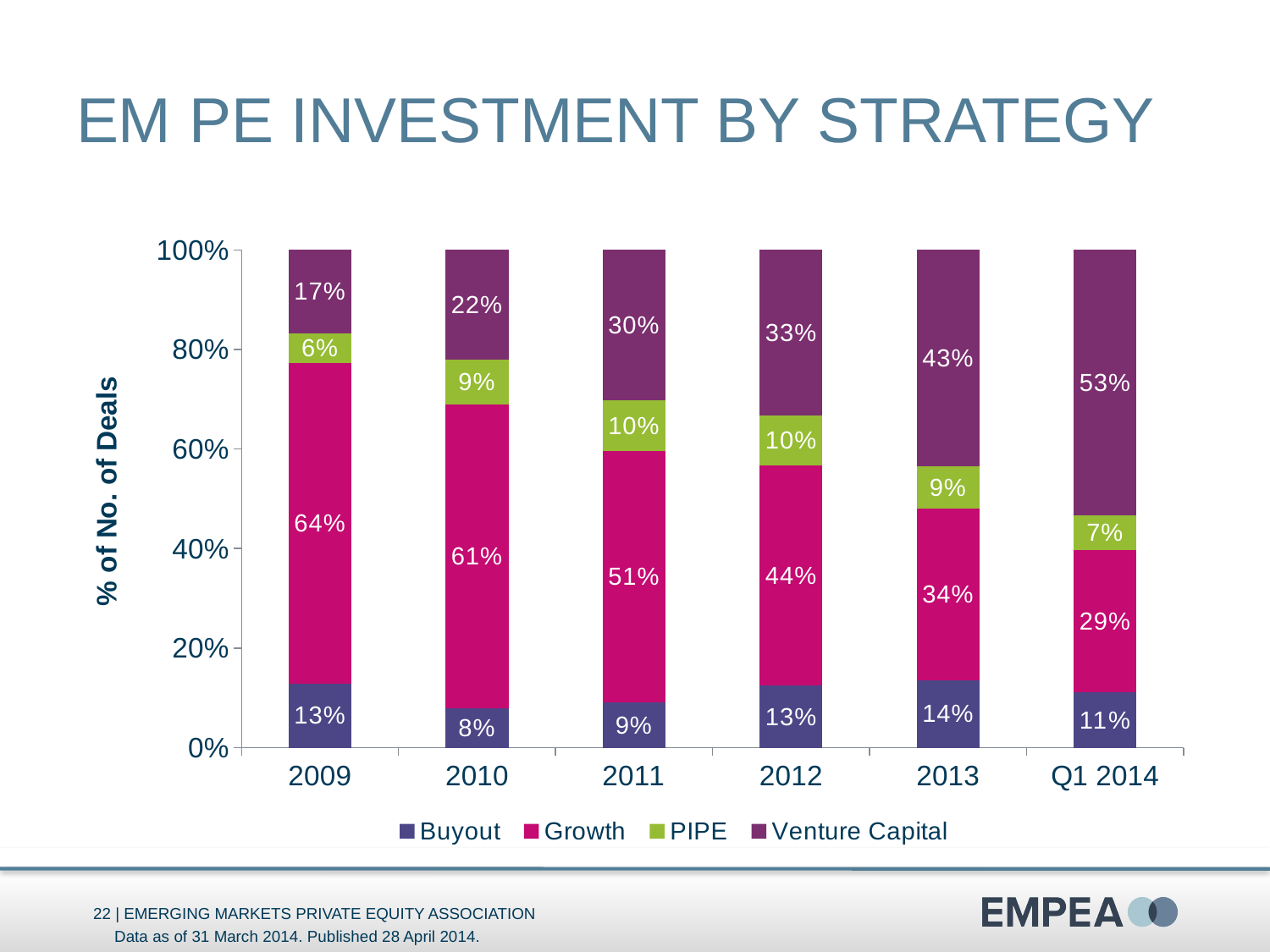
Does the Venture Capital share rise or fall from 2009 to Q1 2014? Rise In which period is the Venture Capital share highest? Q1 2014 Which is larger: the Venture Capital share in 2012 or the Growth share in 2012? Growth share in 2012 What is the Buyout share of deals in 2013? 14% How many periods are shown on the x axis? 6 What is the PIPE share of deals in 2009? 6% What is the Venture Capital share of deals in Q1 2014? 53% What kind of chart is shown? Stacked bar chart What is the difference between the Growth share in 2009 and in Q1 2014? 35% What is the Growth share of deals in 2011? 51% In which period is the Buyout share lowest? 2010 How many series does the legend list? 4